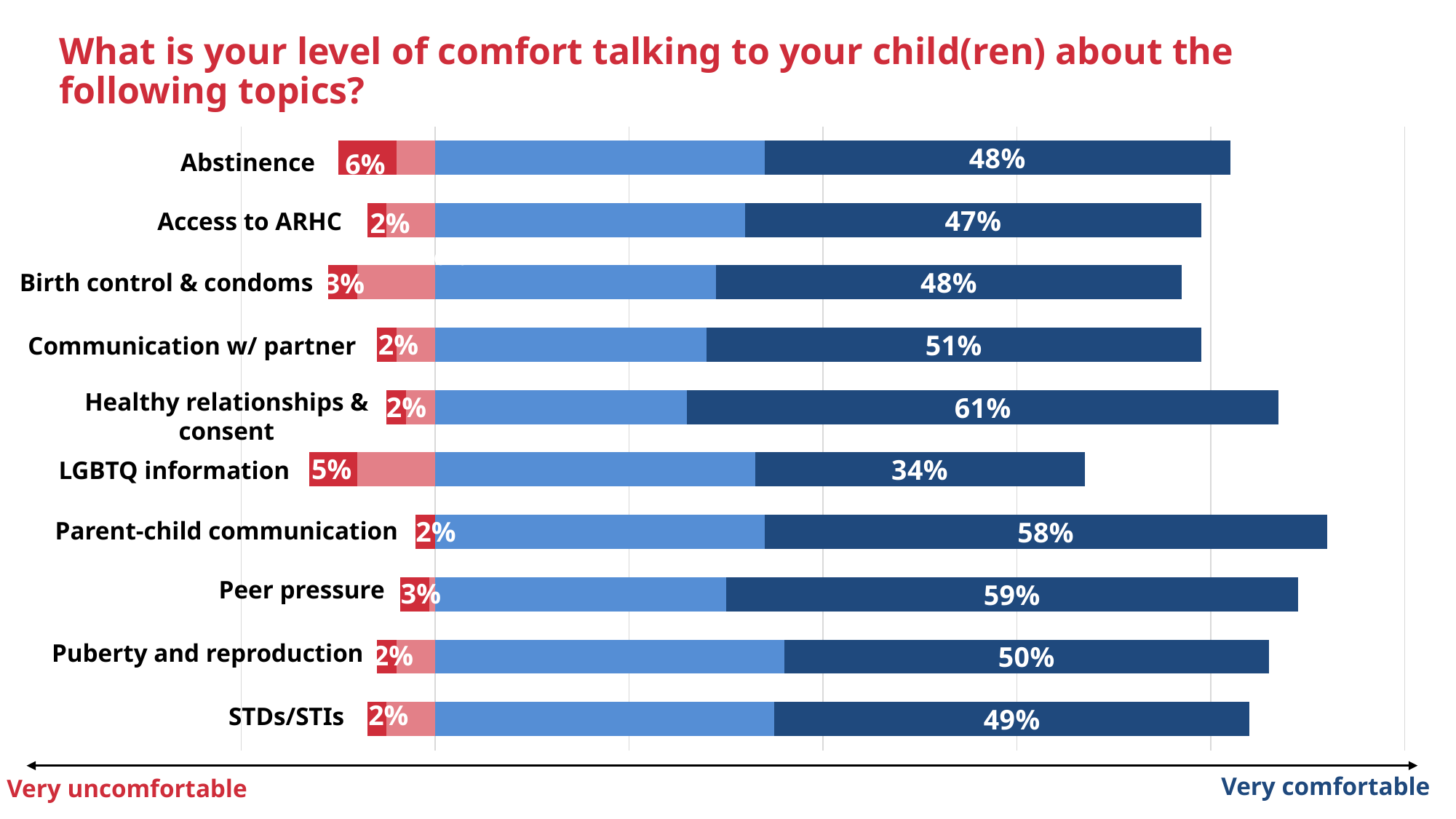
Which has the larger dark blue value, Peer pressure or Parent-child communication? Peer pressure What is the red 'very uncomfortable' value shown for Abstinence? 6% Which topic has the highest red 'very uncomfortable' percentage? Abstinence Which topic has the lowest dark blue 'very comfortable' percentage? LGBTQ information What is the dark blue 'very comfortable' value shown for Healthy relationships & consent? 61% What label appears at the right end of the arrow below the chart? Very comfortable What is the red value shown for Peer pressure? 3% What is the dark blue value shown for LGBTQ information? 34% What is the difference in percentage points between the dark blue values for Healthy relationships & consent and LGBTQ information? 27 Which topic has the highest dark blue 'very comfortable' percentage? Healthy relationships & consent How many topics are listed on the chart? 10 What kind of chart is shown on the slide? Bar chart